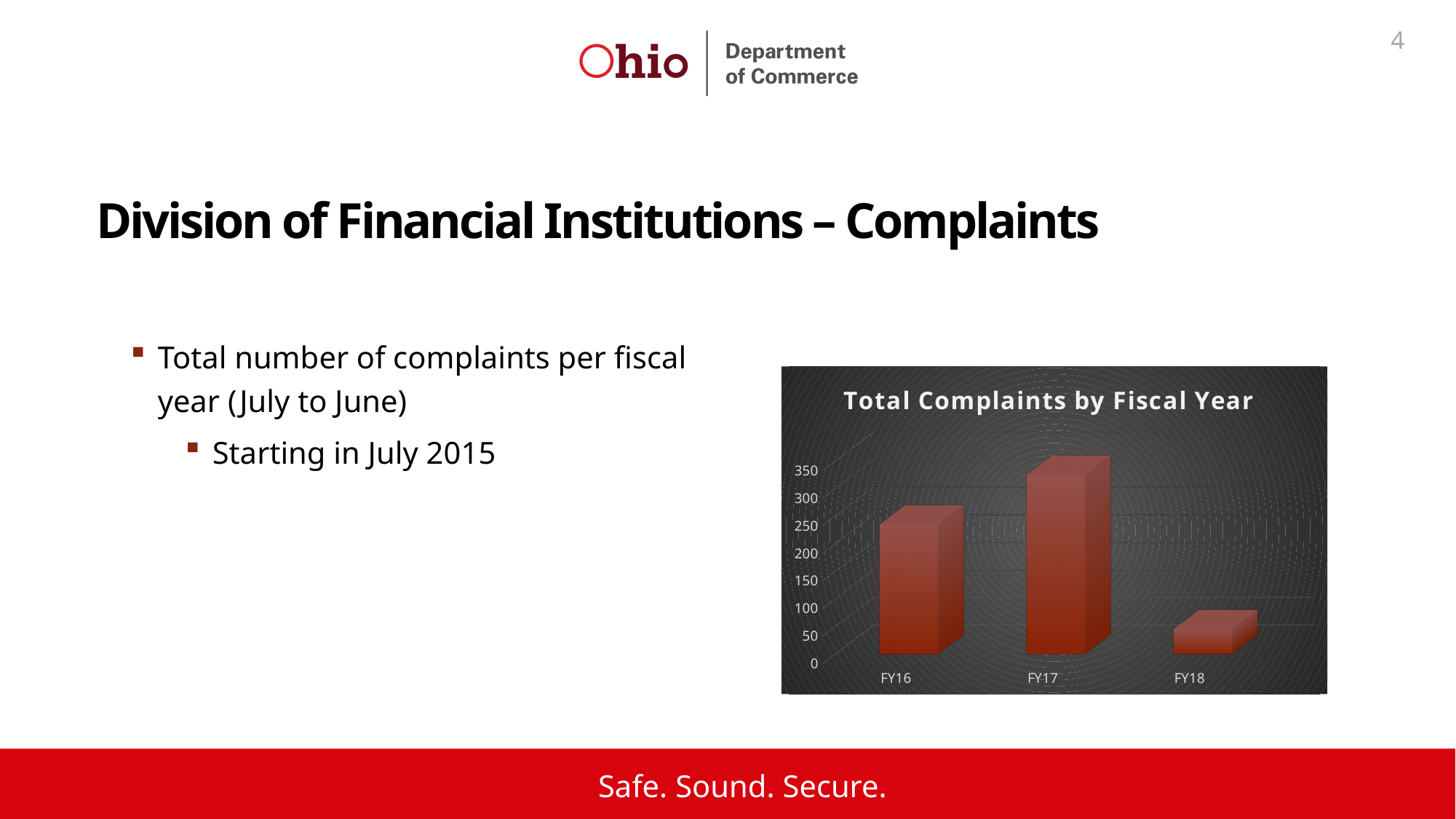
Is the value for FY17 greater or less than 300? greater What kind of chart is shown on the slide? bar chart Which has more complaints, FY16 or FY17? FY17 Does the number of complaints rise or fall from FY17 to FY18? fall Is the value for FY18 greater or less than 100? less Which fiscal year has the highest number of complaints? FY17 Is the value for FY16 greater or less than 200? greater What is the title of the chart? Total Complaints by Fiscal Year Which fiscal year has the lowest number of complaints? FY18 Which has more complaints, FY16 or FY18? FY16 How many fiscal years are plotted in the chart? 3